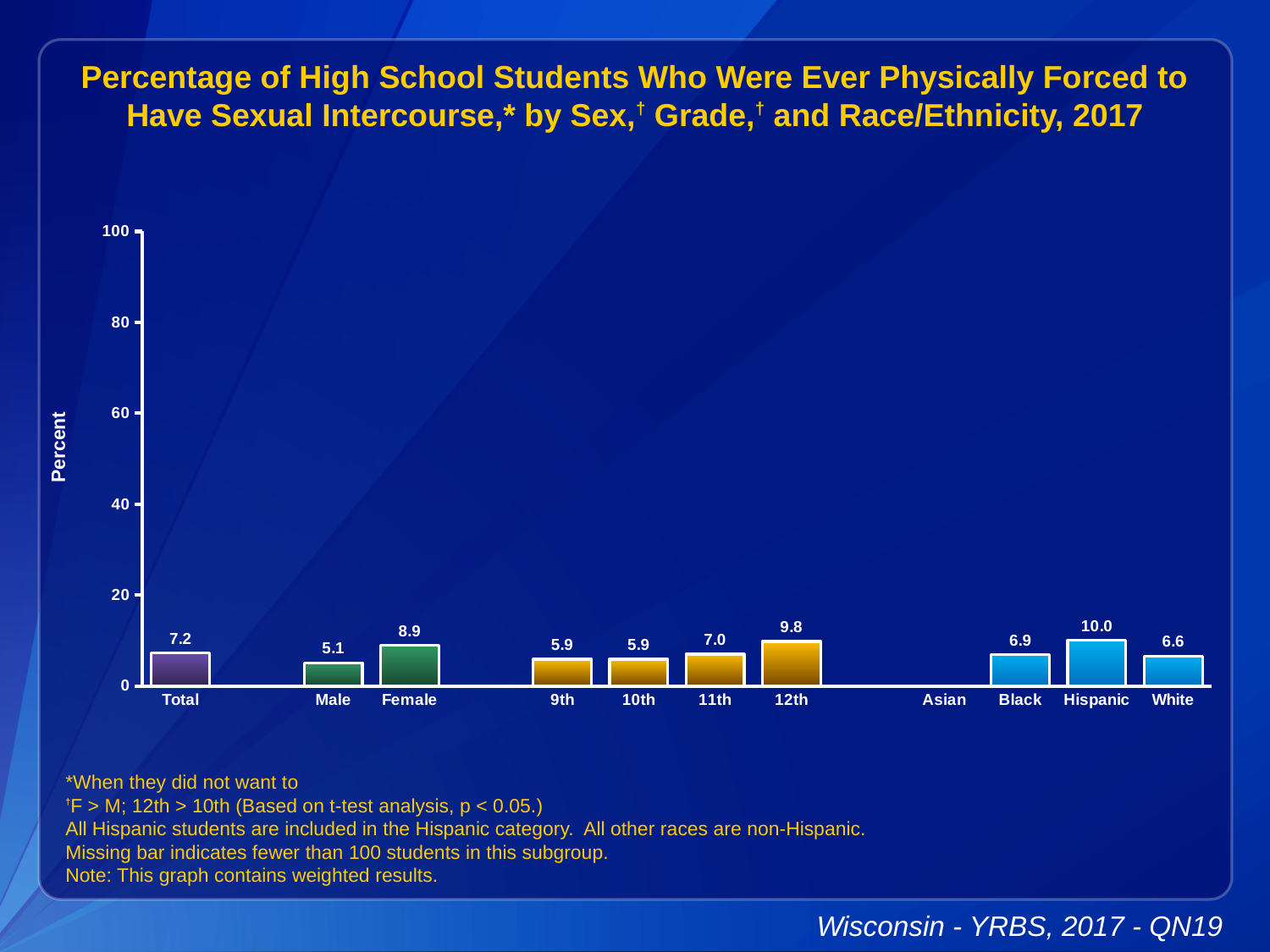
What kind of chart is shown on the slide? bar chart What is the value for 12th grade? 9.8 What is the value for Female? 8.9 Is the value for Hispanic greater or less than 20? less Which is larger, the value for Black or the value for White? Black What is the value for Hispanic? 10.0 What is the difference between the 12th grade and 10th grade values? 3.9 Which category on the x axis has no bar? Asian What is the value for Total? 7.2 Which category has the highest value? Hispanic What is the difference between the Female and Male values? 3.8 Which category with a bar has the lowest value? Male